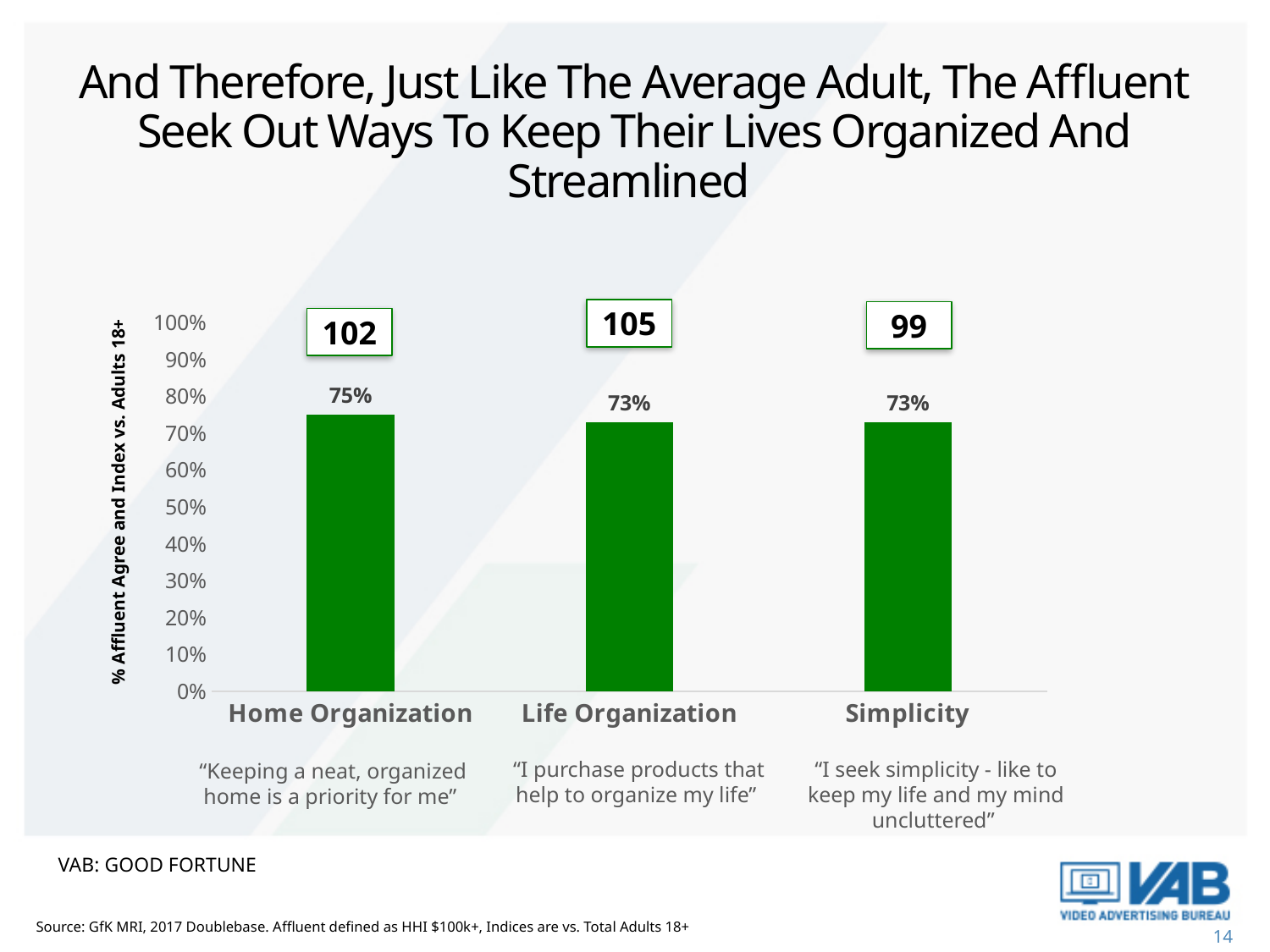
What percentage of affluent adults agree with the Simplicity statement? 73% What is the index vs. Adults 18+ shown above the Simplicity bar? 99 What is the index vs. Adults 18+ shown above the Home Organization bar? 102 What percentage of affluent adults agree with the Life Organization statement? 73% Which category has the highest percentage of affluent adults agreeing? Home Organization Which category has the lowest index vs. Adults 18+? Simplicity Which category has the highest index vs. Adults 18+? Life Organization How many categories are shown in the chart? 3 What kind of chart is shown on the slide? Bar chart What is the index vs. Adults 18+ shown above the Life Organization bar? 105 What is the difference in percentage points between Home Organization and Life Organization? 2 What percentage of affluent adults agree with the Home Organization statement? 75%